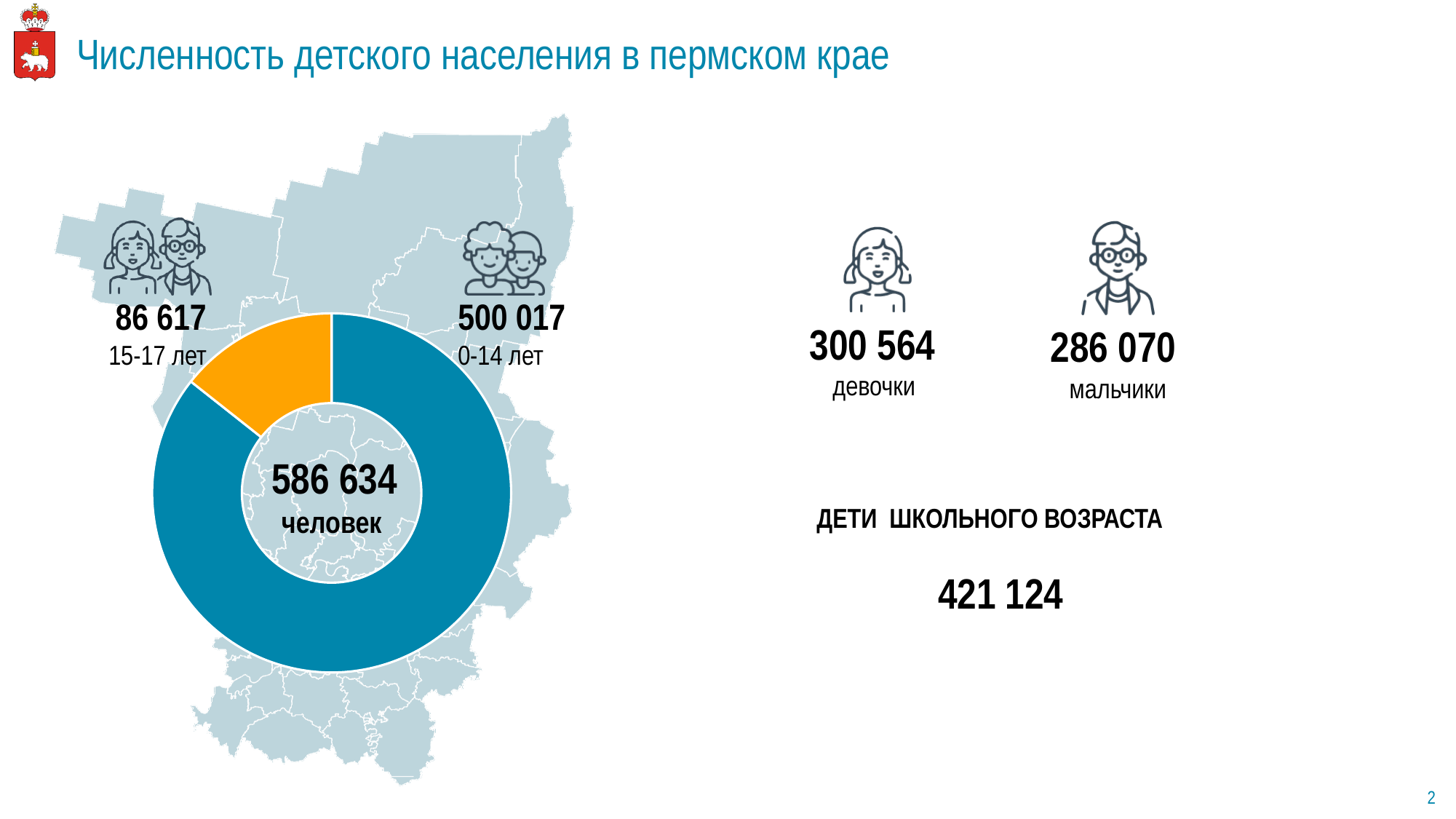
What is the difference between the 0-14 лет and 15-17 лет values in the donut chart? 413 400 What total is shown in the centre of the donut chart? 586 634 человек Which is larger in the donut chart: 0-14 лет or 15-17 лет? 0-14 лет Is the value for 15-17 лет in the donut chart greater or less than 100 000? less What kind of chart is shown on the slide? Donut (pie) chart Which segment of the donut chart is the smallest? 15-17 лет What colour is the 15-17 лет segment of the donut chart? Orange Which segment of the donut chart is the largest? 0-14 лет How many segments does the donut chart have? 2 What is the value for the 15-17 лет segment of the donut chart? 86 617 What colour is the 0-14 лет segment of the donut chart? Blue What is the value for the 0-14 лет segment of the donut chart? 500 017